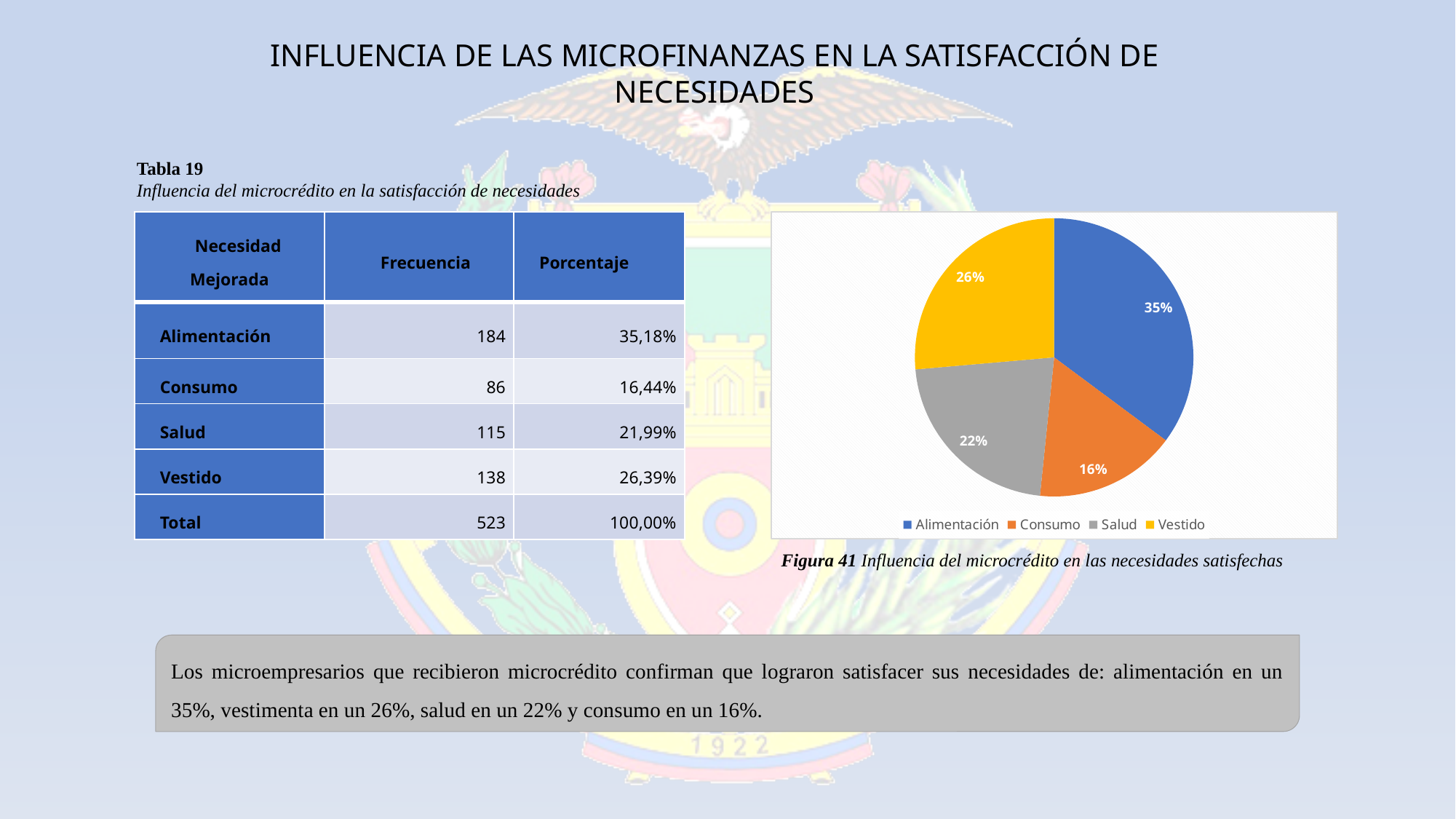
In the pie chart, what share is labelled for Alimentación? 35% In the pie chart, what share is labelled for Vestido? 26% How many entries does the legend of the pie chart list? 4 In the pie chart, what share is labelled for Consumo? 16% What kind of chart is shown in Figura 41? pie chart In the pie chart, what is the difference in percentage points between the Alimentación and Consumo slices? 19 How many slices does the pie chart have? 4 In the pie chart, which slice is larger, Salud or Vestido? Vestido What colour is the Vestido slice in the pie chart? yellow In the pie chart, what share is labelled for Salud? 22% Which category has the smallest slice in the pie chart? Consumo Which category has the largest slice in the pie chart? Alimentación